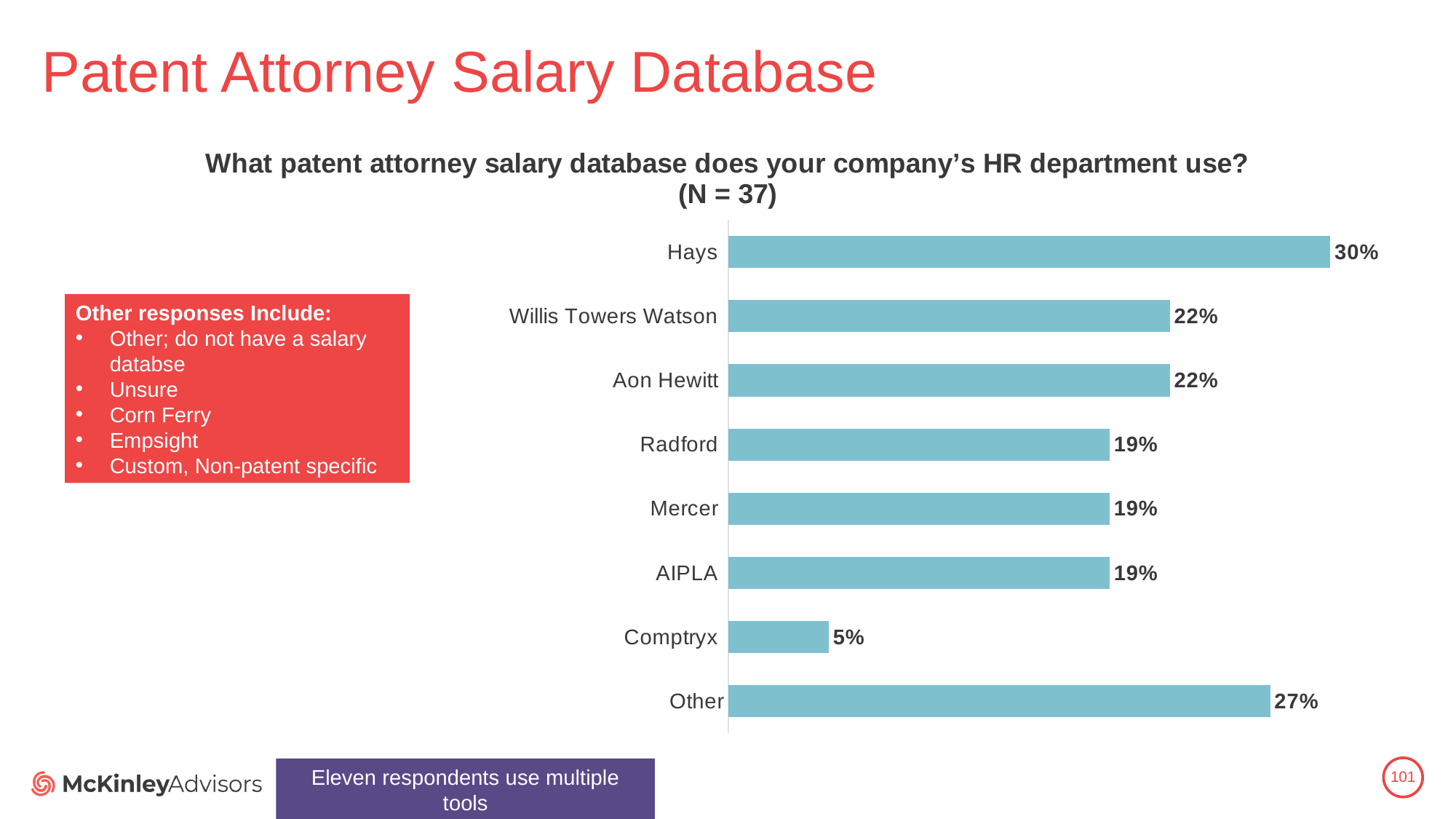
What is the difference in percentage points between Hays and Willis Towers Watson? 8 What percentage of respondents use Hays? 30% What is the sample size (N) stated in the chart title? 37 What percentage of respondents use Radford? 19% Which salary database has the highest percentage of respondents? Hays How many categories are shown in the chart? 8 What percentage of respondents use Comptryx? 5% How many categories are tied at 19%? 3 What percentage of respondents selected Other? 27% Which has a larger share of respondents, Other or Aon Hewitt? Other What kind of chart is shown on the slide? Bar chart Which category has the lowest percentage of respondents? Comptryx